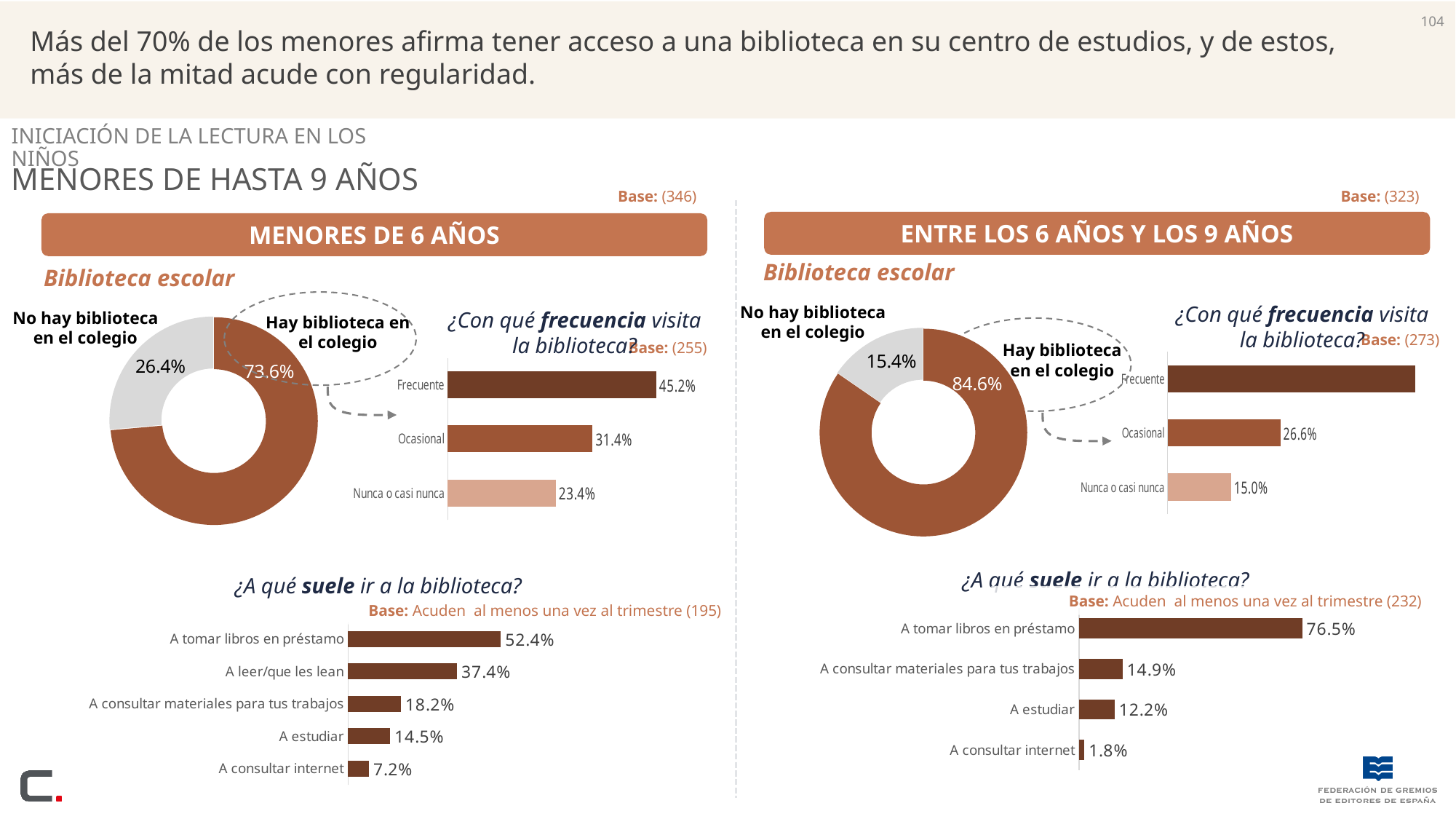
In the '¿Con qué frecuencia visita la biblioteca?' chart for 'MENORES DE 6 AÑOS', what is the difference between 'Frecuente' and 'Nunca o casi nunca'? 21.8% In the '¿Con qué frecuencia visita la biblioteca?' chart for 'MENORES DE 6 AÑOS', which category has the highest value? Frecuente In the '¿A qué suele ir a la biblioteca?' chart for 'ENTRE LOS 6 AÑOS Y LOS 9 AÑOS', which category has the lowest value? A consultar internet In the 'Biblioteca escolar' donut chart for 'MENORES DE 6 AÑOS', what percentage corresponds to 'Hay biblioteca en el colegio'? 73.6% In the 'Biblioteca escolar' donut chart for 'ENTRE LOS 6 AÑOS Y LOS 9 AÑOS', what percentage corresponds to 'No hay biblioteca en el colegio'? 15.4% In the '¿Con qué frecuencia visita la biblioteca?' chart for 'MENORES DE 6 AÑOS', what is the value for 'Ocasional'? 31.4% In the '¿A qué suele ir a la biblioteca?' chart for 'MENORES DE 6 AÑOS', what is the value for 'A leer/que les lean'? 37.4% In the '¿Con qué frecuencia visita la biblioteca?' chart for 'ENTRE LOS 6 AÑOS Y LOS 9 AÑOS', what is the value for 'Nunca o casi nunca'? 15.0% What type of chart is used to show 'Biblioteca escolar' for 'MENORES DE 6 AÑOS'? Donut chart In the '¿A qué suele ir a la biblioteca?' chart for 'ENTRE LOS 6 AÑOS Y LOS 9 AÑOS', what is the value for 'A tomar libros en préstamo'? 76.5% Which is larger: 'A consultar materiales para tus trabajos' in the '¿A qué suele ir a la biblioteca?' chart for 'MENORES DE 6 AÑOS' or the same category in the chart for 'ENTRE LOS 6 AÑOS Y LOS 9 AÑOS'? MENORES DE 6 AÑOS (18.2%) In the '¿A qué suele ir a la biblioteca?' chart for 'MENORES DE 6 AÑOS', how many categories are shown? 5